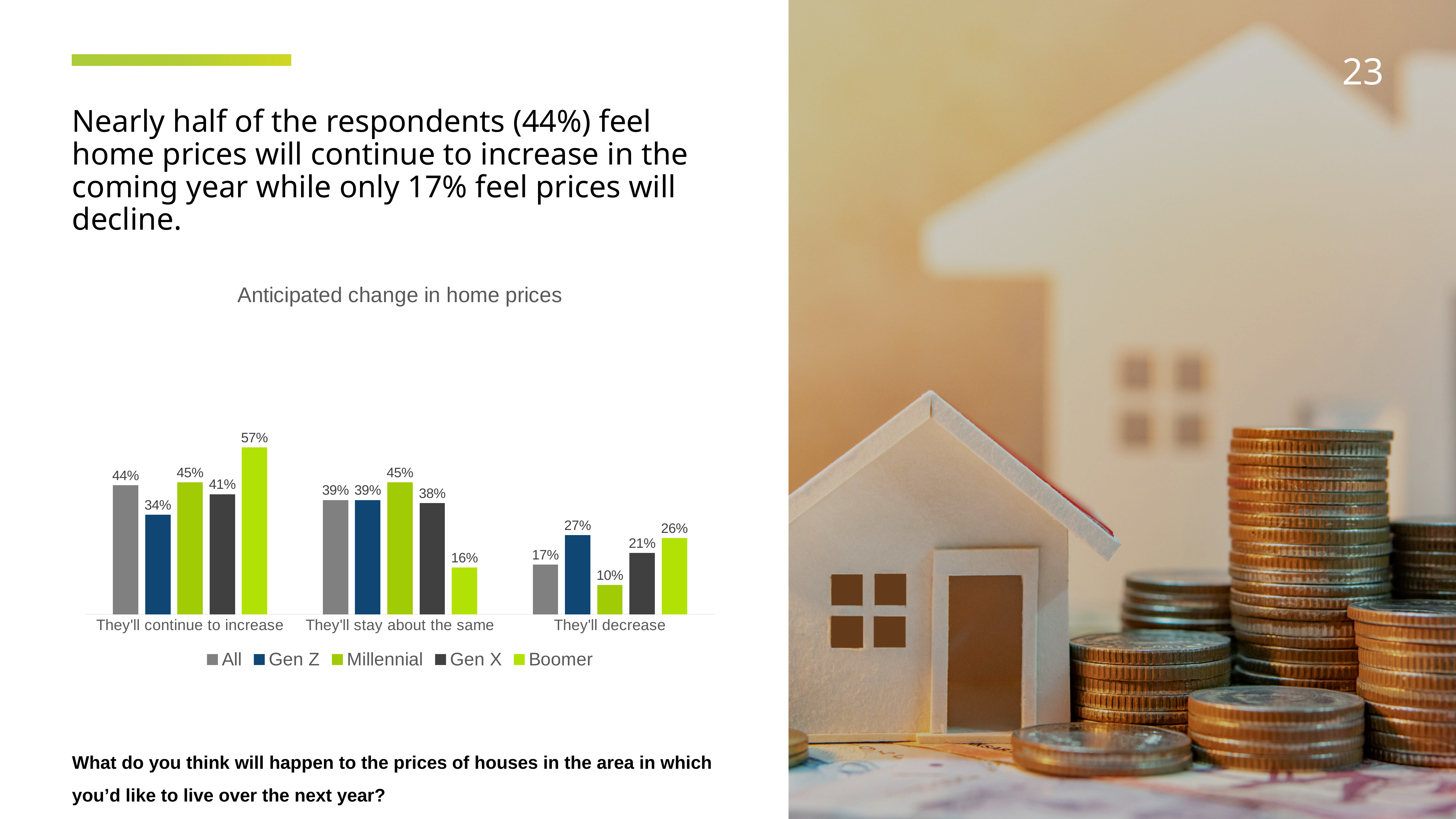
Which generation has the lowest value in the 'They'll decrease' category? Millennial How many response categories are shown on the x axis? 3 What is the value for Gen Z in the 'They'll decrease' category? 27% What percentage of Millennial respondents think prices will stay about the same? 45% What is the value for All respondents in the 'They'll stay about the same' category? 39% What is the title of the chart? Anticipated change in home prices What is the difference between the Boomer and Gen Z values for 'They'll continue to increase'? 23 percentage points How many series does the legend list? 5 What percentage of Boomer respondents think home prices will continue to increase? 57% Which generation has the highest value in the 'They'll continue to increase' category? Boomer What kind of chart is shown on the slide? Bar chart Which is larger: the Gen X value for 'They'll decrease' or the Boomer value for 'They'll decrease'? Boomer